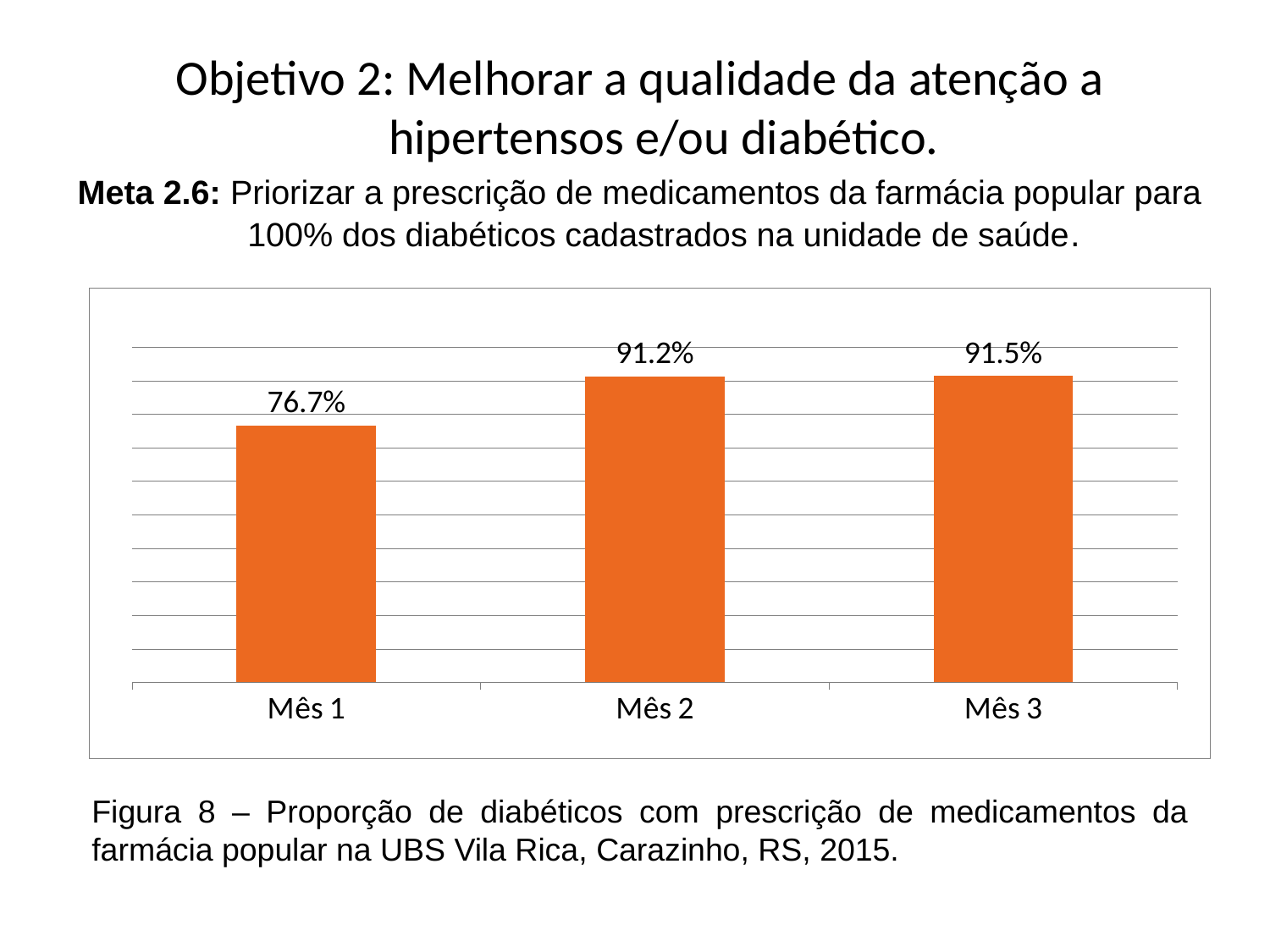
Which is larger, the value for Mês 1 or the value for Mês 2? Mês 2 Which month has the highest value according to the data labels? Mês 3 What is the difference between the values for Mês 2 and Mês 1? 14.5 percentage points Do the values rise or fall from Mês 1 to Mês 3? Rise Which month has the lowest value? Mês 1 What is the value for Mês 1? 76.7% What kind of chart is shown on the slide? Bar chart What colour are the bars in the chart? Orange What is the difference between the values for Mês 3 and Mês 1? 14.8 percentage points What is the value for Mês 2? 91.2% How many categories are shown on the x axis? 3 What is the value for Mês 3? 91.5%